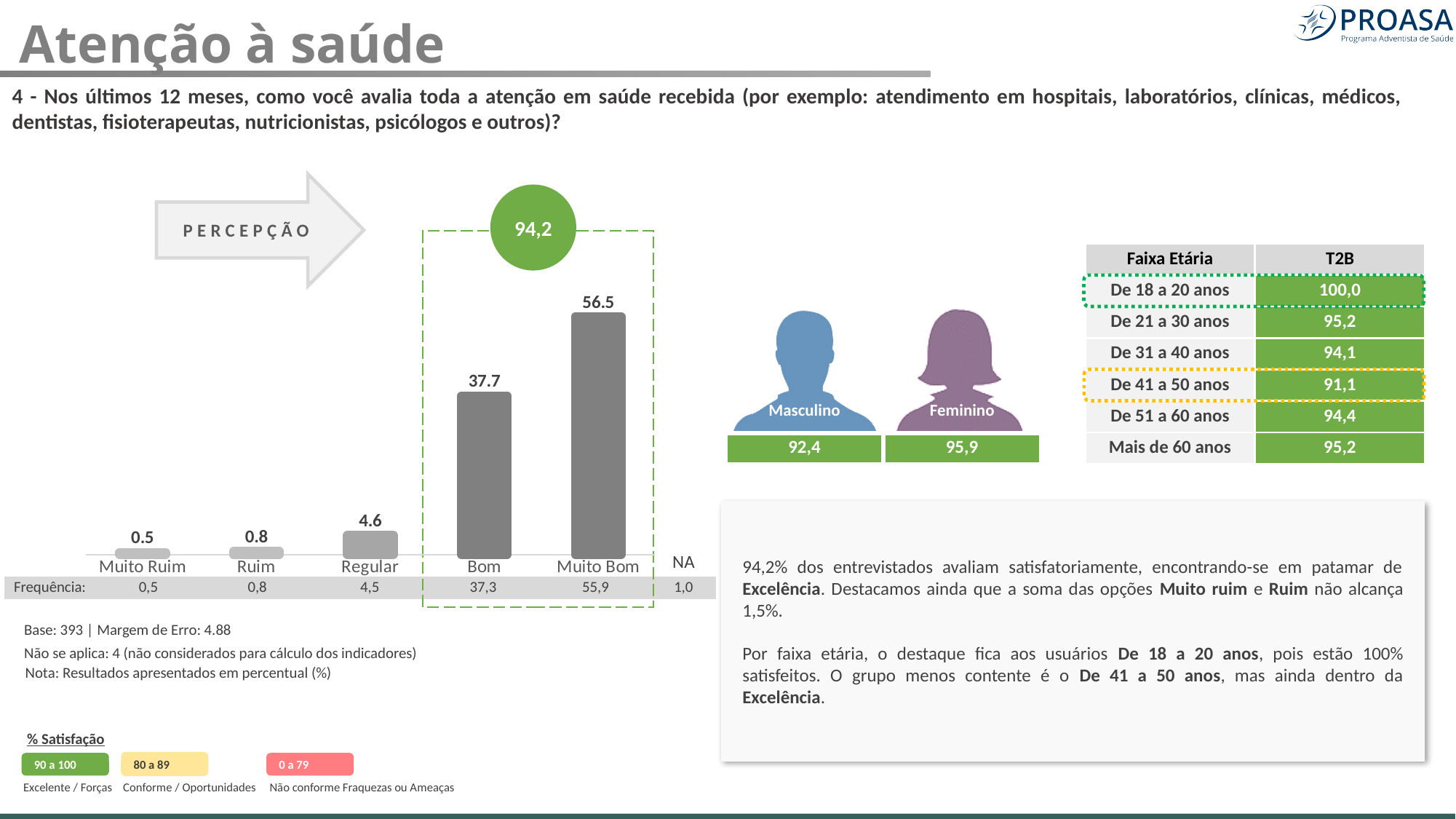
What is the value shown for the Muito Ruim bar? 0.5 Do the bar values rise or fall from Muito Ruim to Muito Bom along the x axis? rise How many bars are plotted in the chart? 5 What value is shown in the green circle above the dashed box around Bom and Muito Bom? 94,2 What is the value shown for the Muito Bom bar? 56.5 What is the value shown for the Bom bar? 37.7 Which category has the highest bar? Muito Bom What kind of chart is shown on the slide? bar chart What is the value shown for the Regular bar? 4.6 Which is larger, the value for Regular or the value for Ruim? Regular What is the difference between the Muito Bom and Bom bar values? 18.8 Which category has the lowest bar? Muito Ruim